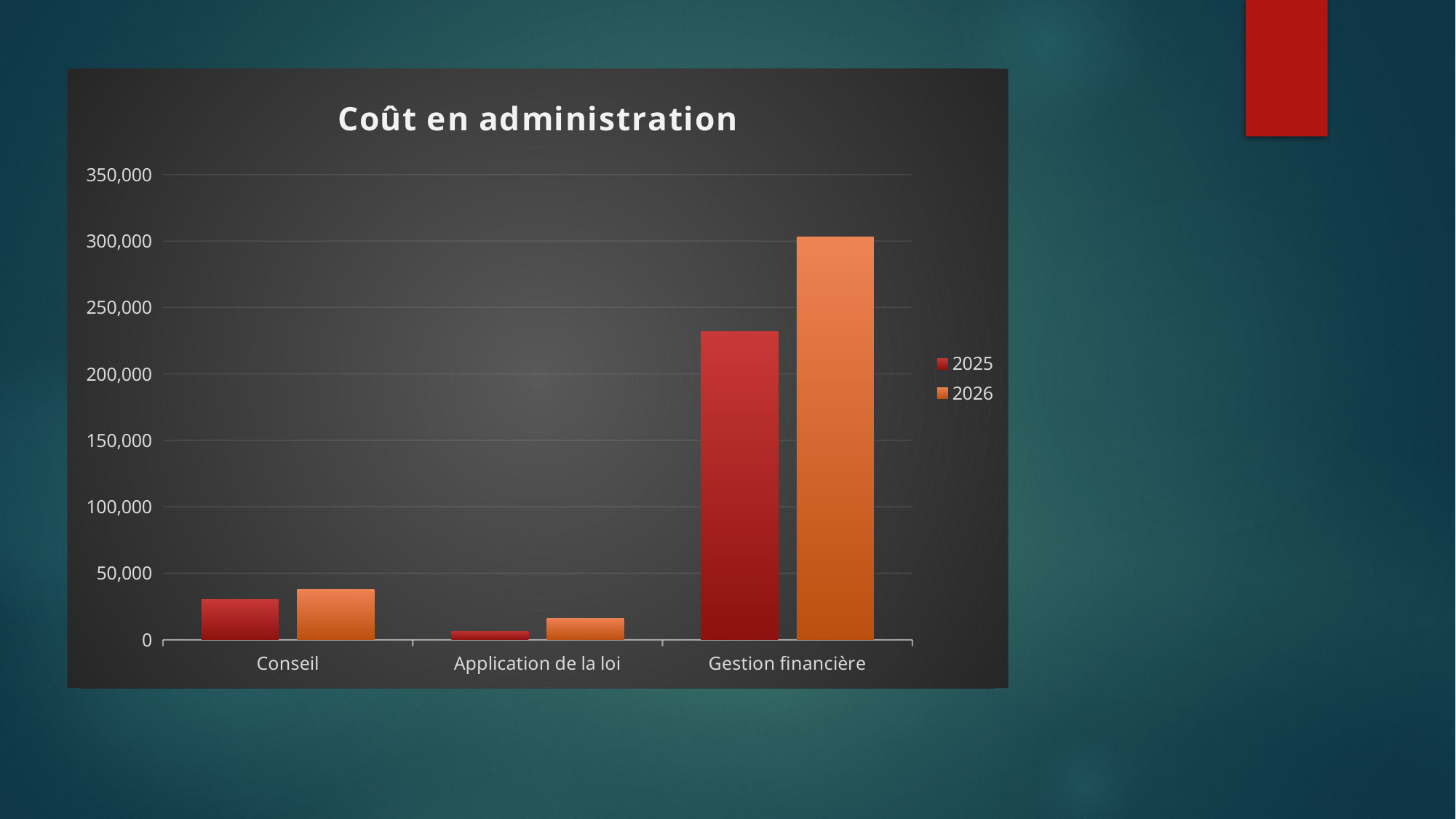
Is the value for Conseil in 2025 greater or less than 50,000? less How many categories are shown on the x axis of the chart? 3 What is the title of the chart? Coût en administration What kind of chart is shown on the slide? bar chart Which category has the lowest value for 2025? Application de la loi Is the value for Gestion financière in 2026 greater or less than 250,000? greater For Gestion financière, which series has the larger value, 2025 or 2026? 2026 How many series does the legend list? 2 Is the value for Gestion financière in 2025 greater or less than 200,000? greater Which category has the highest value for 2026? Gestion financière Which series are listed in the legend? 2025 and 2026